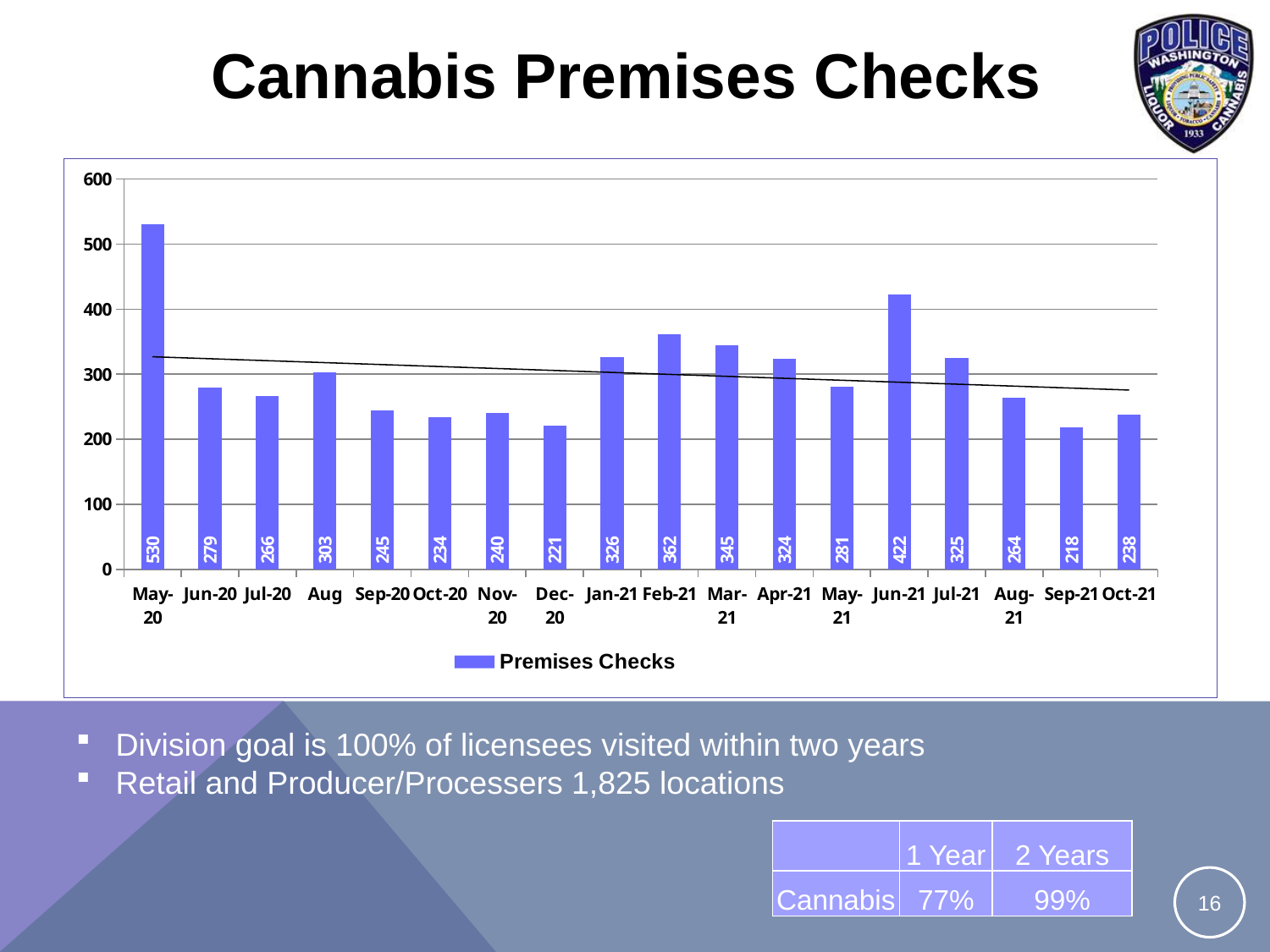
How many months are plotted in the chart? 18 Which month has the highest number of premises checks? May-20 What is the difference between the values for Jun-21 and Jul-21? 97 How many premises checks are shown for Jun-21? 422 Is the value for Aug-21 greater or less than 300? less What is the value for Dec-20? 221 What kind of chart is shown on the slide? bar chart Which is larger, the value for Mar-21 or the value for Apr-21? Mar-21 How many series does the legend list? 1 What is the value for Feb-21 in the Premises Checks chart? 362 What is the difference between the values for May-20 and Jun-20? 251 Which month has the lowest number of premises checks? Sep-21